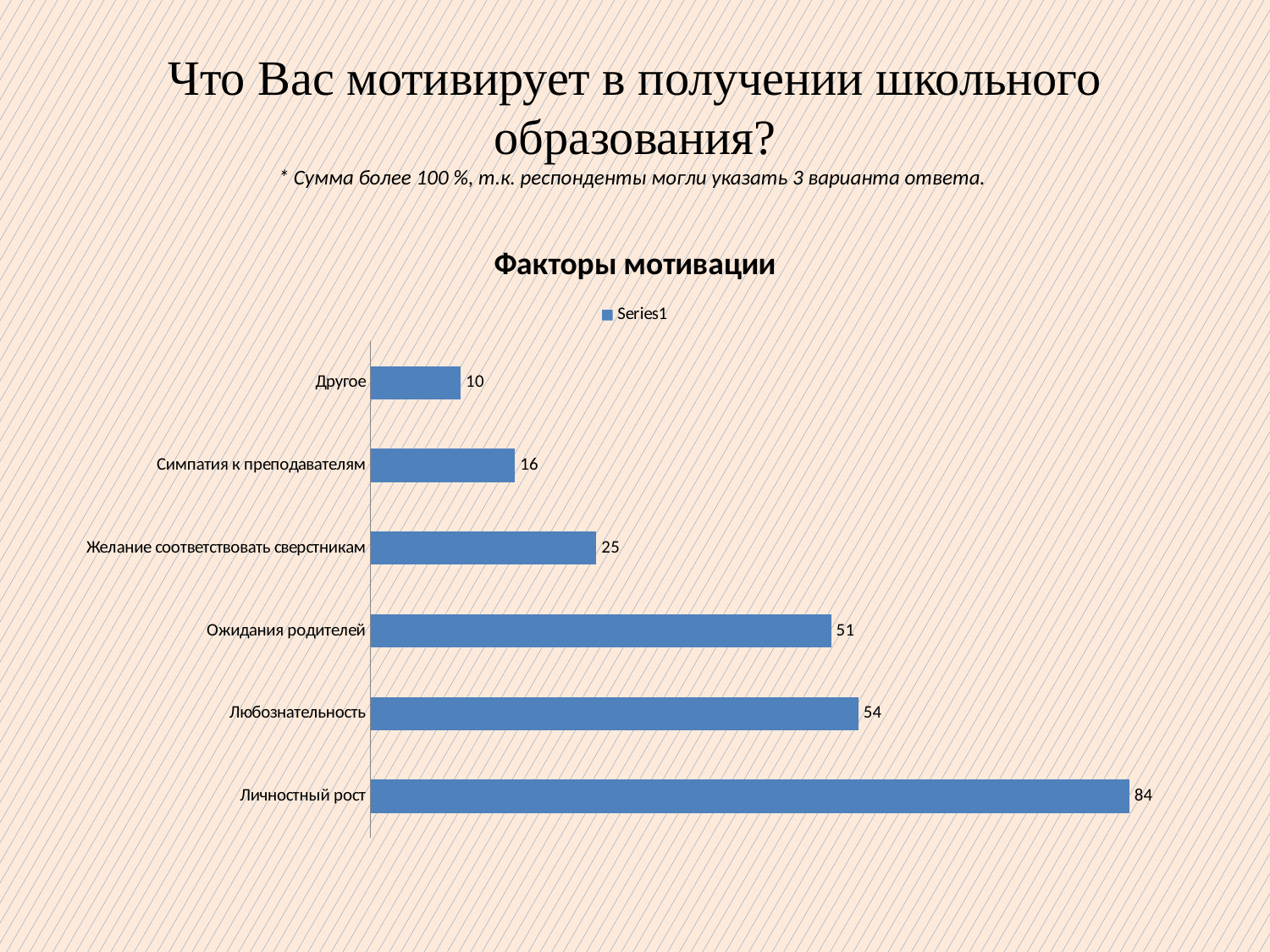
What is the value for Симпатия к преподавателям? 16 Which is larger, the value for Ожидания родителей or the value for Желание соответствовать сверстникам? Ожидания родителей What is the difference between the values for Желание соответствовать сверстникам and Другое? 15 Which category has the lowest value? Другое How many categories are shown in the chart? 6 How many series does the legend list? 1 What is the value for Ожидания родителей? 51 What is the value for Личностный рост? 84 What kind of chart is shown on the slide? Bar chart What is the title of the chart? Факторы мотивации What is the difference between the values for Личностный рост and Любознательность? 30 Which category has the highest value? Личностный рост